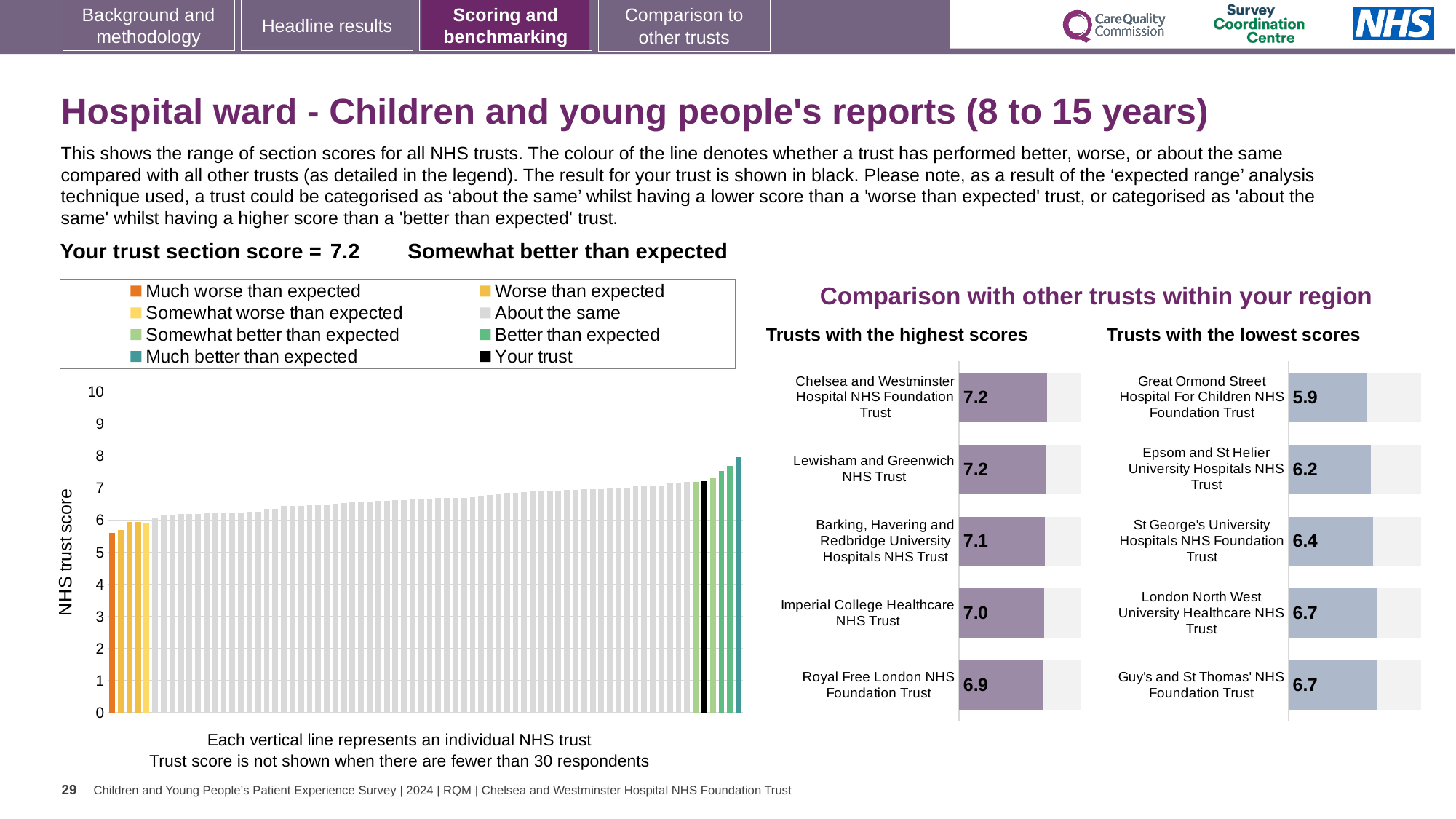
In the large chart on the left, what is the label of the y axis? NHS trust score In the 'Trusts with the highest scores' chart, what is the score for Imperial College Healthcare NHS Trust? 7.0 In the 'Trusts with the highest scores' chart, what is the difference between the scores of Chelsea and Westminster Hospital NHS Foundation Trust and Royal Free London NHS Foundation Trust? 0.3 In the large chart on the left, is the value for the black bar (Your trust) greater or less than 7? greater In the 'Trusts with the lowest scores' chart, which has the higher score: Epsom and St Helier University Hospitals NHS Trust or St George's University Hospitals NHS Foundation Trust? St George's University Hospitals NHS Foundation Trust In the 'Trusts with the lowest scores' chart, what is the score for St George's University Hospitals NHS Foundation Trust? 6.4 In the 'Trusts with the highest scores' chart, how many trusts are shown? 5 In the 'Trusts with the lowest scores' chart, which trust has the lowest score? Great Ormond Street Hospital For Children NHS Foundation Trust What kind of chart is the large chart on the left showing NHS trust scores? bar chart In the large chart on the left, how many entries does the legend list? 8 In the 'Trusts with the lowest scores' chart, what is the difference between the scores of Guy's and St Thomas' NHS Foundation Trust and Great Ormond Street Hospital For Children NHS Foundation Trust? 0.8